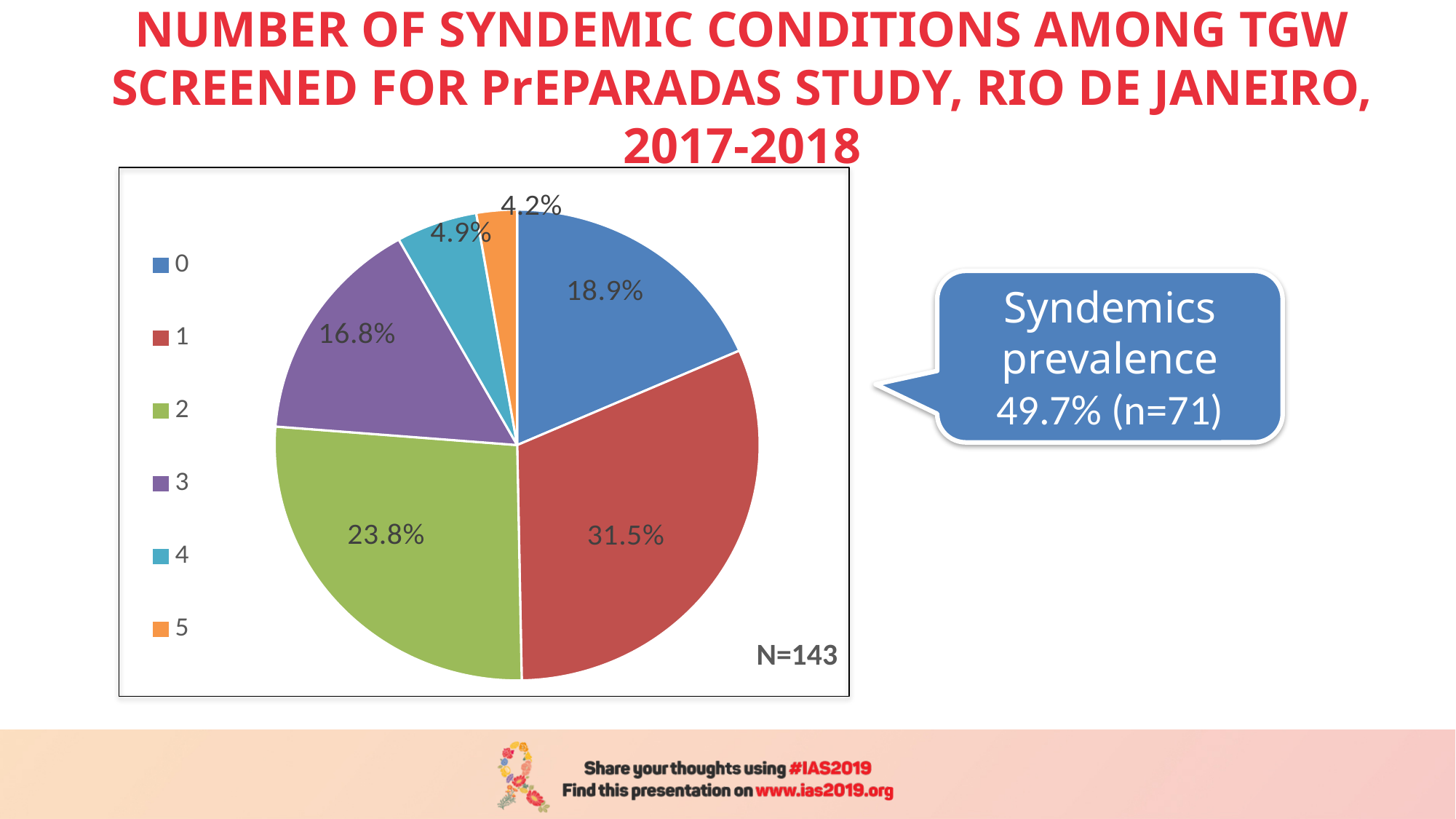
What share of the pie corresponds to 1 syndemic condition? 31.5% How many categories does the legend list? 6 What share of the pie corresponds to 0 syndemic conditions? 18.9% What is the difference in percentage points between the slices for 1 and 2 syndemic conditions? 7.7 What share of the pie corresponds to 3 syndemic conditions? 16.8% Which slice is larger, the one for 0 conditions or the one for 3 conditions? 0 What kind of chart is shown on the slide? Pie chart What is the total sample size (N) shown on the chart? N=143 Which category has the largest slice of the pie? 1 Which category has the smallest slice of the pie? 5